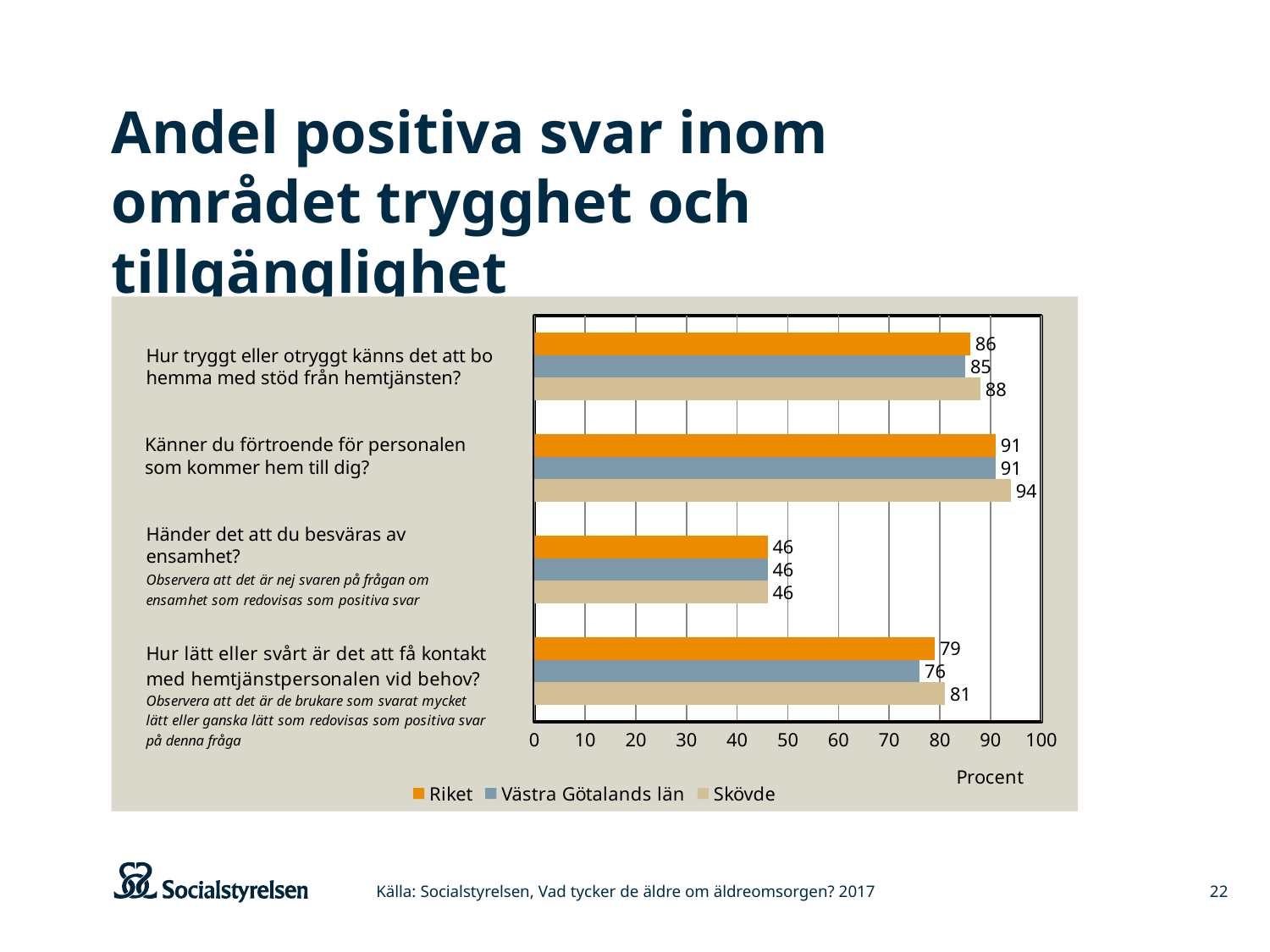
Which question has the highest value for Riket? Känner du förtroende för personalen som kommer hem till dig? How many series does the legend list? 3 What is the difference between the Skövde value and the Västra Götalands län value on the question "Hur lätt eller svårt är det att få kontakt med hemtjänstpersonalen vid behov?"? 5 On the question "Hur tryggt eller otryggt känns det att bo hemma med stöd från hemtjänsten?", which is larger: the value for Skövde or the value for Riket? Skövde Is the value for Riket on the question "Händer det att du besväras av ensamhet?" greater or less than 50? less Which question has the lowest value for Skövde? Händer det att du besväras av ensamhet? How many questions (categories) are shown in the chart? 4 What is the label on the horizontal axis of the chart? Procent What is the value for Västra Götalands län on the question "Hur tryggt eller otryggt känns det att bo hemma med stöd från hemtjänsten?"? 85 What is the value for Skövde on the question "Känner du förtroende för personalen som kommer hem till dig?"? 94 What is the value for Riket on the question "Hur lätt eller svårt är det att få kontakt med hemtjänstpersonalen vid behov?"? 79 What kind of chart is shown on the slide? bar chart